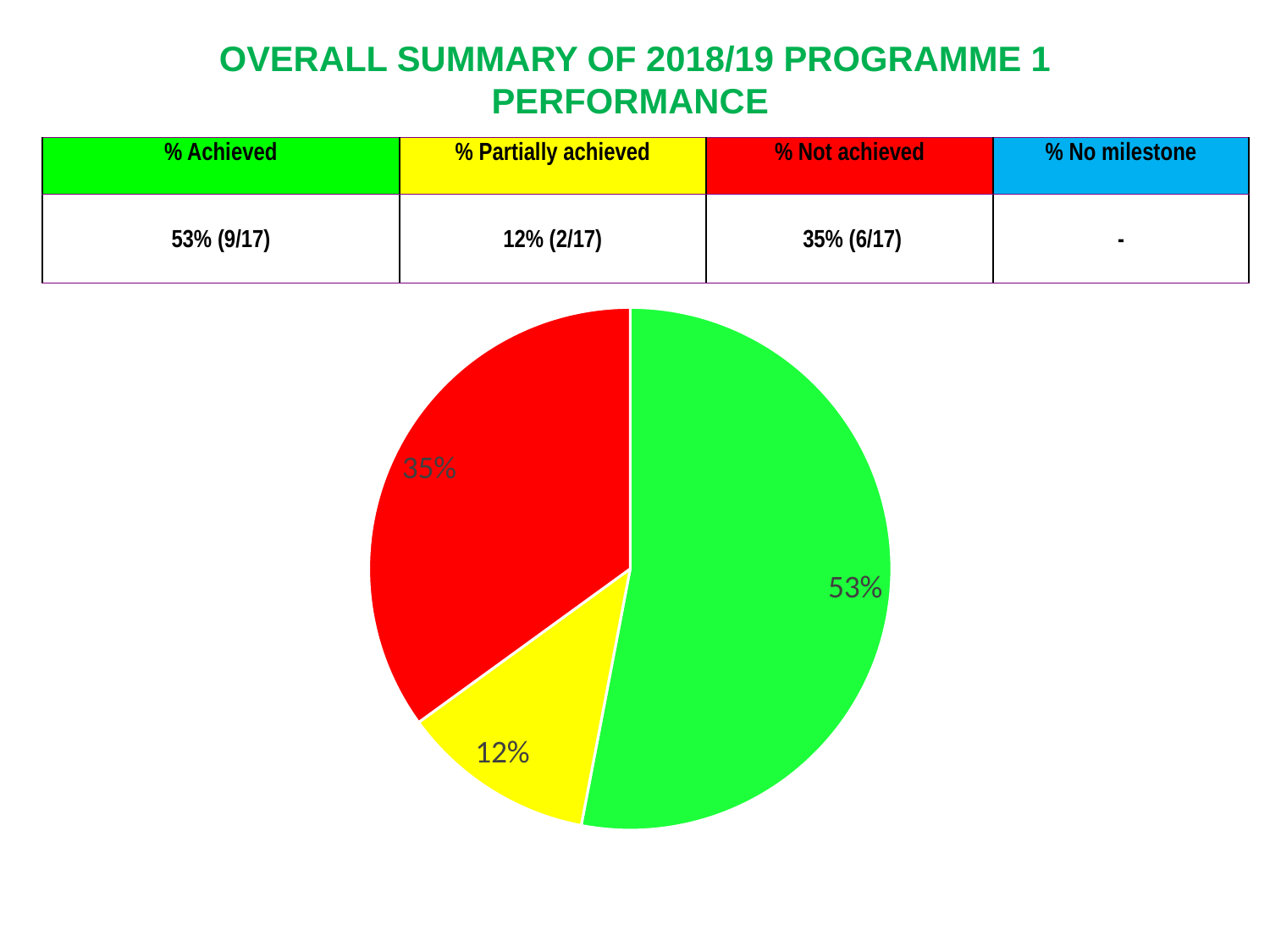
Which slice of the pie chart is the smallest? the yellow slice (12%) What is the difference in percentage points between the green slice and the red slice of the pie chart? 18 How many slices does the pie chart have? 3 What kind of chart is shown on the slide? pie chart What percentage is shown on the yellow slice of the pie chart? 12% According to the table above the pie chart, what percentage of milestones was partially achieved? 12% (2/17) Which slice of the pie chart is the largest? the green slice (53%) What is the title shown at the top of the slide? OVERALL SUMMARY OF 2018/19 PROGRAMME 1 PERFORMANCE What percentage is shown on the green slice of the pie chart? 53% What percentage is shown on the red slice of the pie chart? 35% Is the red slice or the yellow slice of the pie chart larger? the red slice What share of the pie does the red slice represent? 35%